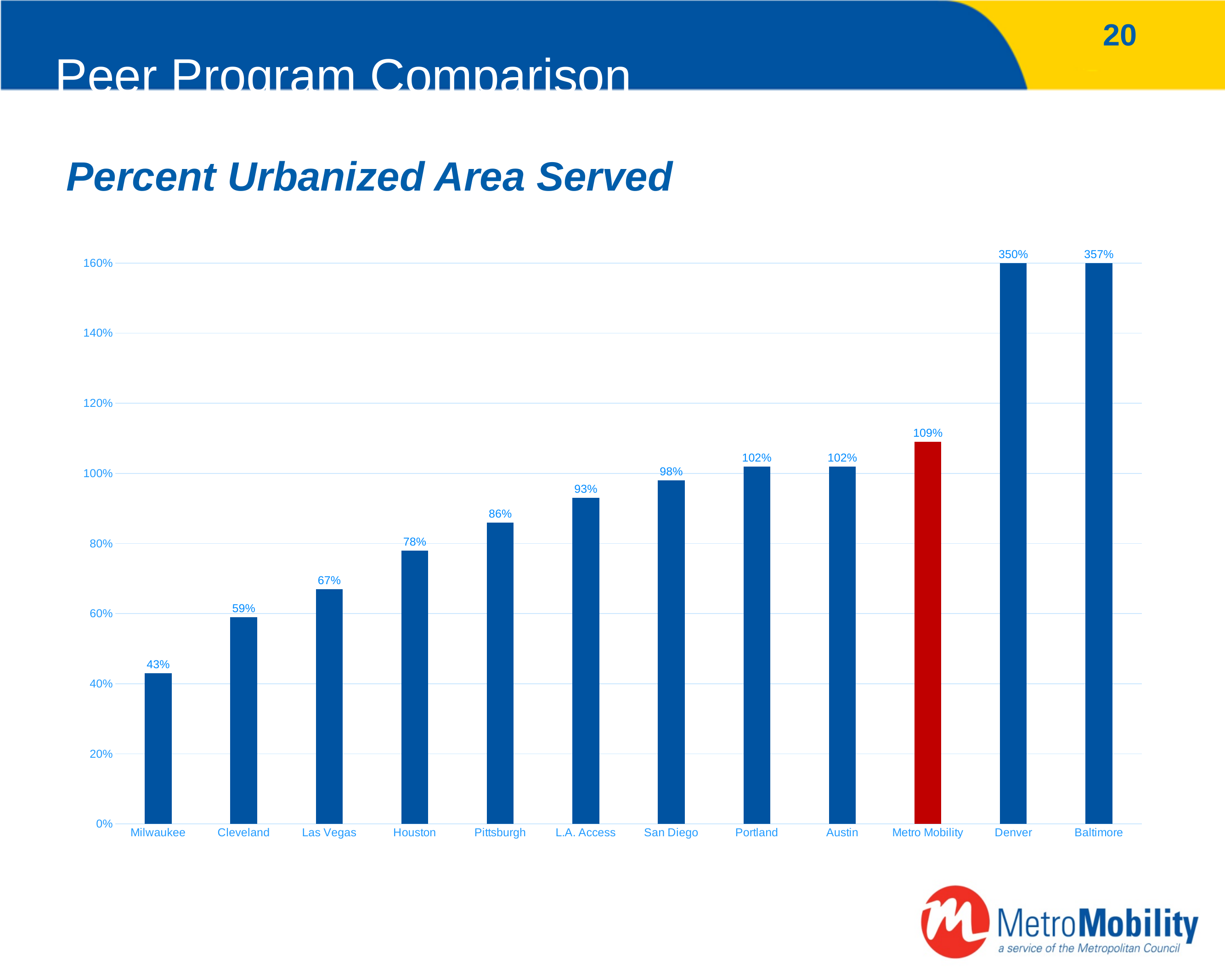
Which program has the lowest percent urbanized area served? Milwaukee What is the difference between the values for Baltimore and Denver? 7% What is the difference between the values for Metro Mobility and San Diego? 11% What is the percent urbanized area served for Milwaukee? 43% What is the percent urbanized area served for Baltimore? 357% Which program has the highest percent urbanized area served? Baltimore What is the percent urbanized area served for Metro Mobility? 109% How many programs are shown on the x axis of the chart? 12 Which has a larger value, Pittsburgh or Las Vegas? Pittsburgh What is the percent urbanized area served for Houston? 78% Which bar in the chart is coloured red rather than blue? Metro Mobility What kind of chart is shown on the slide? Bar chart